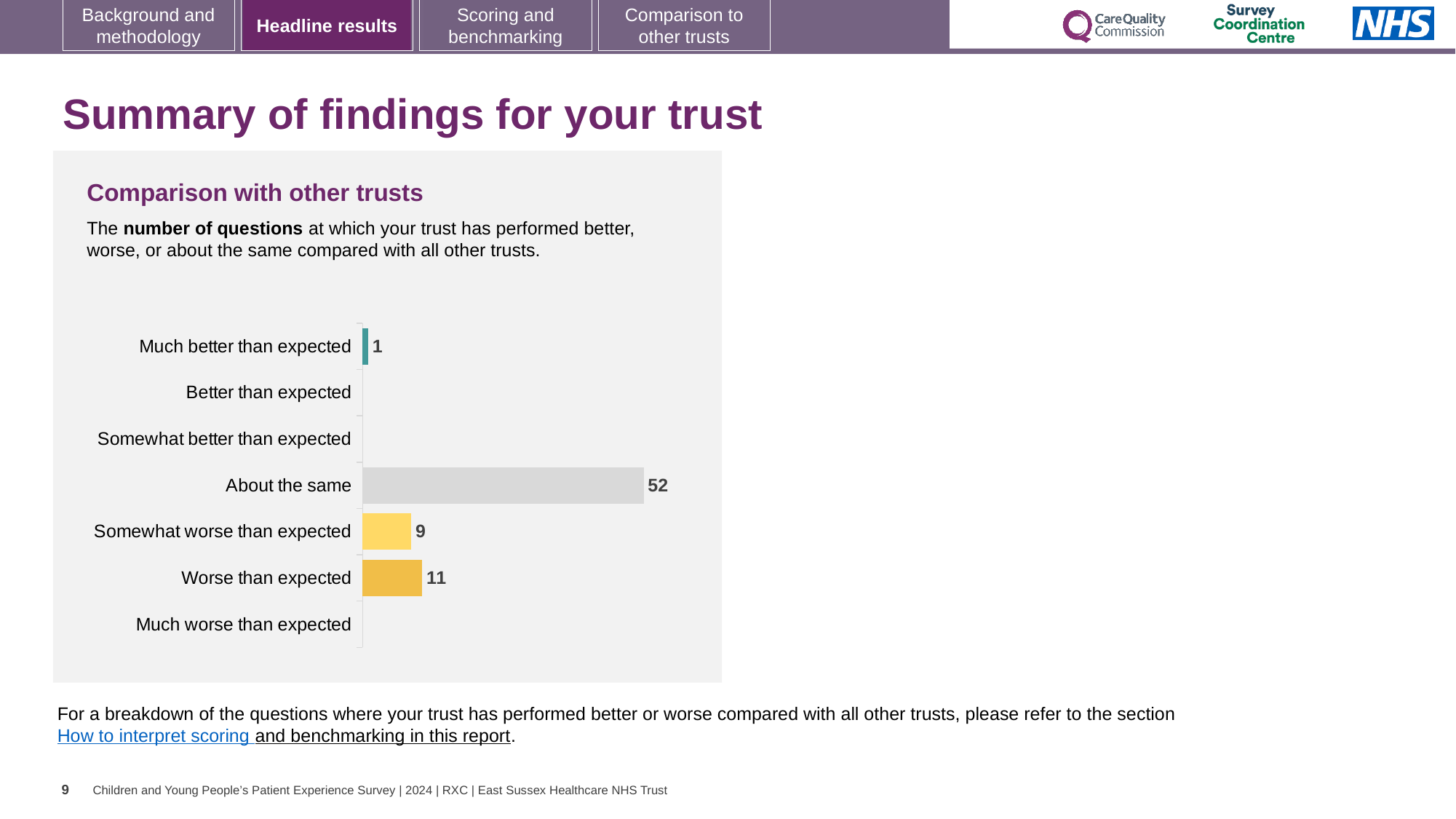
How many categories are shown on the chart? 7 What is the title of the chart? Comparison with other trusts Which category has the highest value? About the same What is the value for 'About the same'? 52 Which is larger, 'Worse than expected' or 'Somewhat worse than expected'? Worse than expected What is the difference between 'Worse than expected' and 'Somewhat worse than expected'? 2 What colour is the bar for 'About the same'? Grey What is the difference between 'About the same' and 'Worse than expected'? 41 What is the value for 'Worse than expected'? 11 What kind of chart is shown? Bar chart What is the value for 'Somewhat worse than expected'? 9 What is the value for 'Much better than expected'? 1